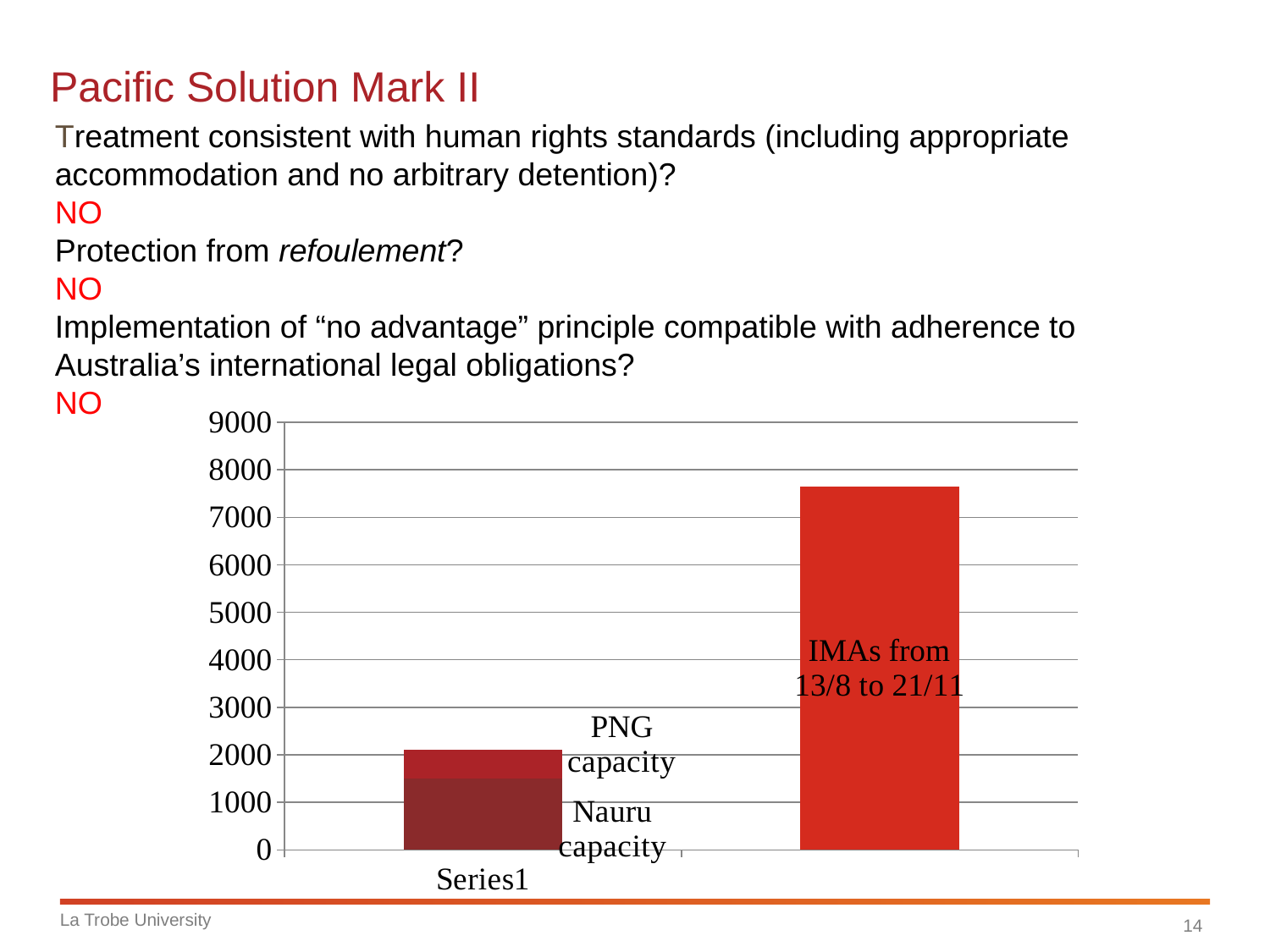
What is the highest value shown on the vertical axis of the chart? 9000 What label appears under the stacked capacity bar on the horizontal axis? Series1 Is the Nauru capacity segment greater or less than 2000? less Is the Nauru capacity segment greater or less than 1000? greater Which segment of the stacked capacity bar is larger, Nauru capacity or PNG capacity? Nauru capacity How many bars are plotted in the chart? 2 Is the value for IMAs from 13/8 to 21/11 greater or less than 8000? less What kind of chart is shown on the slide? bar chart Which is larger: the IMAs from 13/8 to 21/11 bar or the combined Nauru and PNG capacity bar? IMAs from 13/8 to 21/11